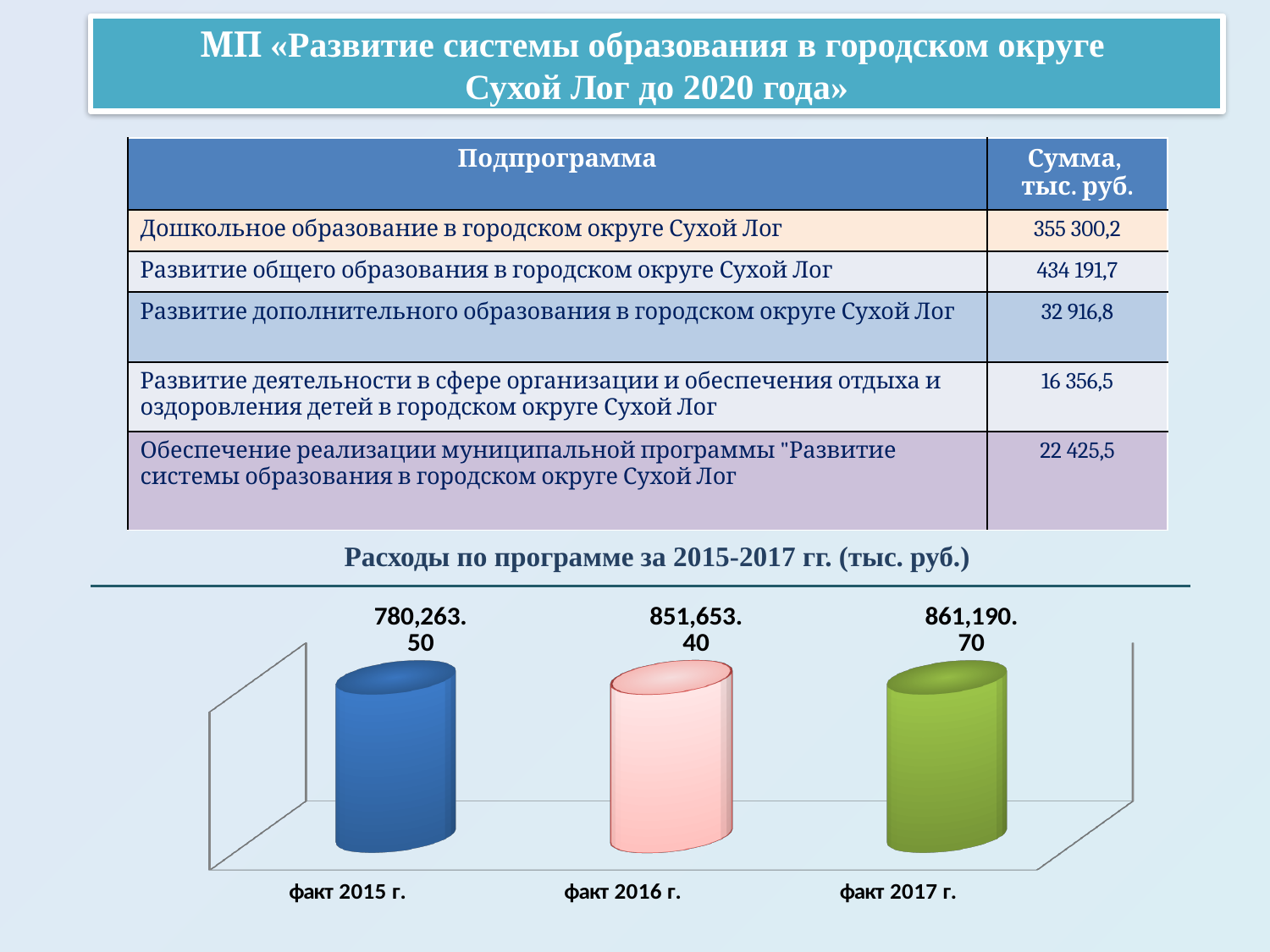
Which is larger, the value for факт 2016 г. or факт 2017 г.? факт 2017 г. What kind of chart is shown on the slide? bar chart What is the value for факт 2015 г. in the chart? 780,263.50 What is the value for факт 2016 г. in the chart? 851,653.40 Do the values rise or fall from факт 2015 г. to факт 2017 г.? rise Which year has the highest value in the chart? факт 2017 г. What is the value for факт 2017 г. in the chart? 861,190.70 What is the difference between the values for факт 2017 г. and факт 2015 г.? 80,927.20 What is the difference between the values for факт 2016 г. and факт 2015 г.? 71,389.90 How many categories are shown in the chart? 3 Which year has the lowest value in the chart? факт 2015 г. What is the difference between the values for факт 2017 г. and факт 2016 г.? 9,537.30